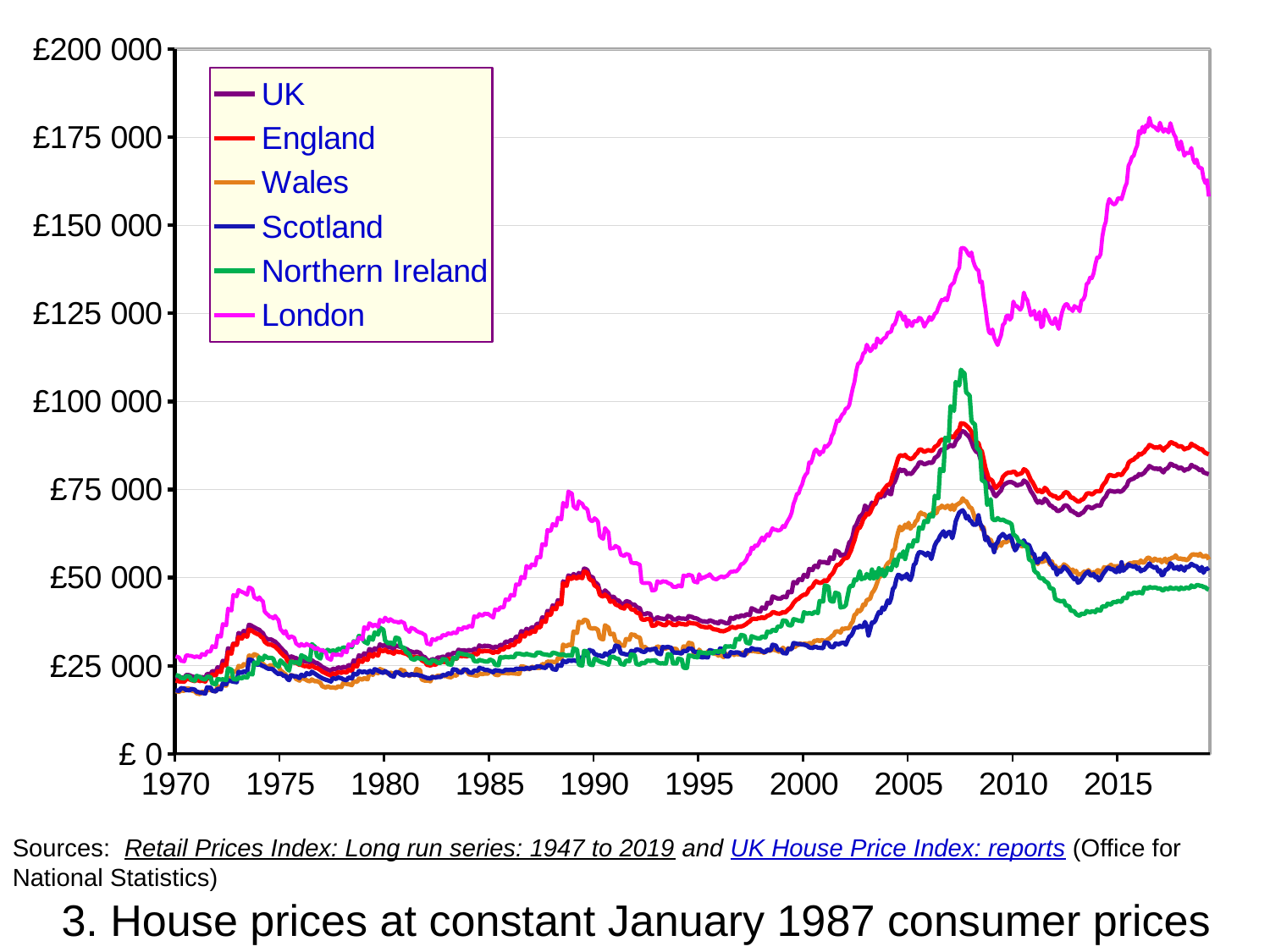
What colour is the line for London? Magenta (pink) Is the value for London in 1995 greater or less than £75 000? less Is the peak value for Northern Ireland around 2007 greater or less than £100 000? greater How many series does the legend list? 6 Does the London series rise or fall between 2010 and 2017? Rise In 2015, which is larger: the value for Wales or the value for Northern Ireland? Wales Is the value for Scotland in 1970 greater or less than £25 000? less Which series reaches the highest value on the chart? London In 2015, which is larger: the value for London or the value for Scotland? London Which series has the lowest value at the right-hand end of the chart (around 2019)? Northern Ireland What kind of chart is shown on the slide? Line chart